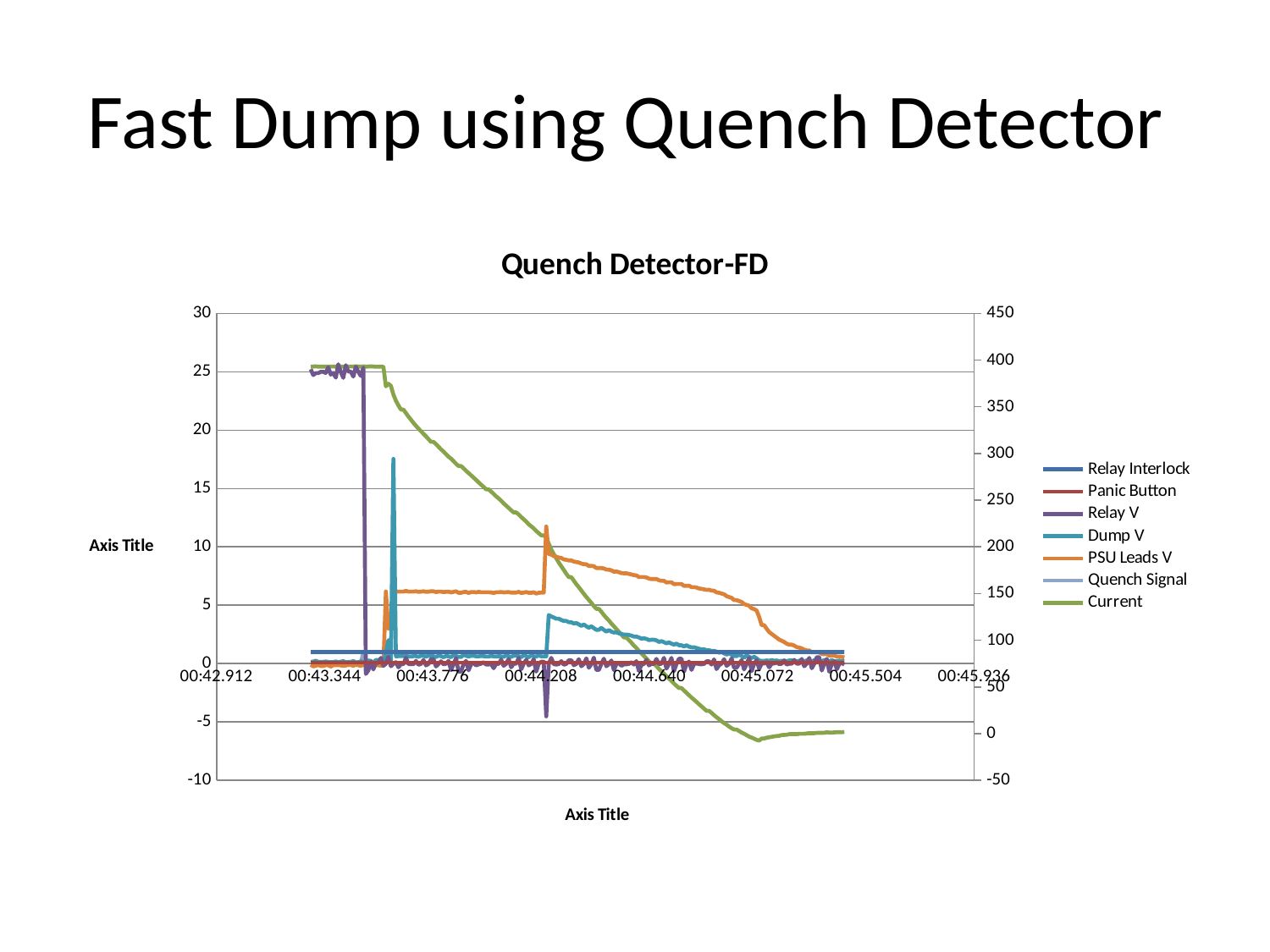
On the left axis, is the value of Relay V at the start of the trace (around 00:43.344) greater or less than 20? greater Does the Current series rise or fall along the x axis? fall On the left axis, is the value of Relay V at 00:43.776 greater or less than 5? less Which series has the highest peak value on the left axis scale, Relay V or Panic Button? Relay V What kind of chart is shown on the slide? line chart Which series is listed last in the legend? Current Which series reaches a higher peak on the left axis, Dump V or PSU Leads V? Dump V On the left axis, is the peak value of Dump V greater or less than 15? greater What is the title of the chart? Quench Detector-FD How many series does the legend list? 7